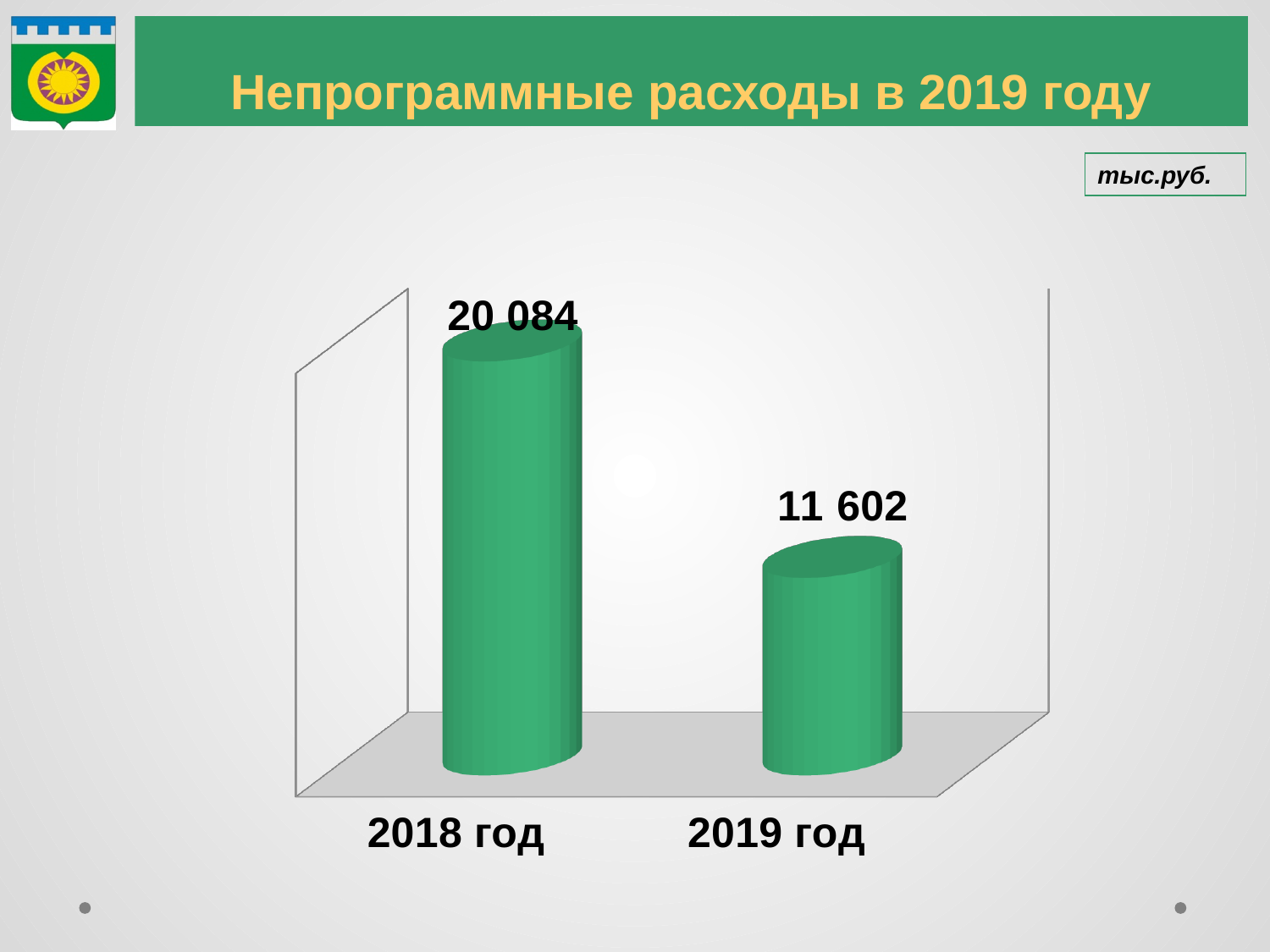
Which year has the lowest value? 2019 год What is the title of the slide? Непрограммные расходы в 2019 году What is the difference between the values for 2018 год and 2019 год? 8 482 What is the value for 2018 год? 20 084 How many categories are shown in the chart? 2 What kind of chart is shown on the slide? bar chart In what units are the chart values given? тыс.руб. Which year has the highest value? 2018 год Which is larger, the value for 2018 год or for 2019 год? 2018 год Do the values rise or fall from 2018 год to 2019 год? fall What is the value for 2019 год? 11 602